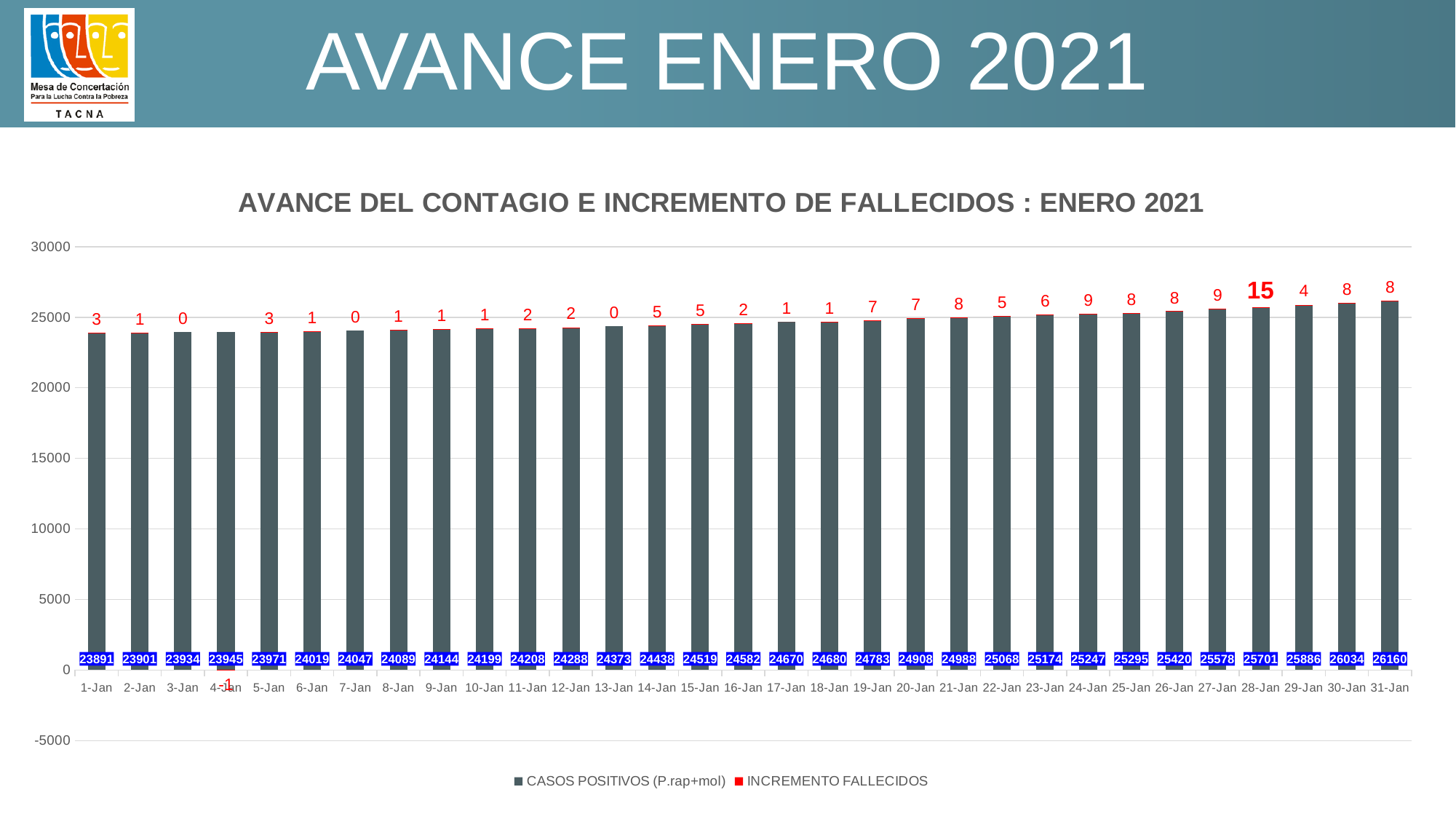
On which date is INCREMENTO FALLECIDOS lowest? 4-Jan What is the difference in CASOS POSITIVOS (P.rap+mol) between 31-Jan and 1-Jan? 2269 What is the INCREMENTO FALLECIDOS value on 28-Jan? 15 Which date has a higher INCREMENTO FALLECIDOS value, 24-Jan or 29-Jan? 24-Jan What kind of chart is shown on the slide? bar chart Is the value of CASOS POSITIVOS (P.rap+mol) on 15-Jan greater or less than 25000? less How many dates are shown on the x axis? 31 How many series does the legend list? 2 On which date is INCREMENTO FALLECIDOS highest? 28-Jan Do the CASOS POSITIVOS (P.rap+mol) values rise or fall from 1-Jan to 31-Jan? rise What is the value of CASOS POSITIVOS (P.rap+mol) on 31-Jan? 26160 What is the value of CASOS POSITIVOS (P.rap+mol) on 1-Jan? 23891